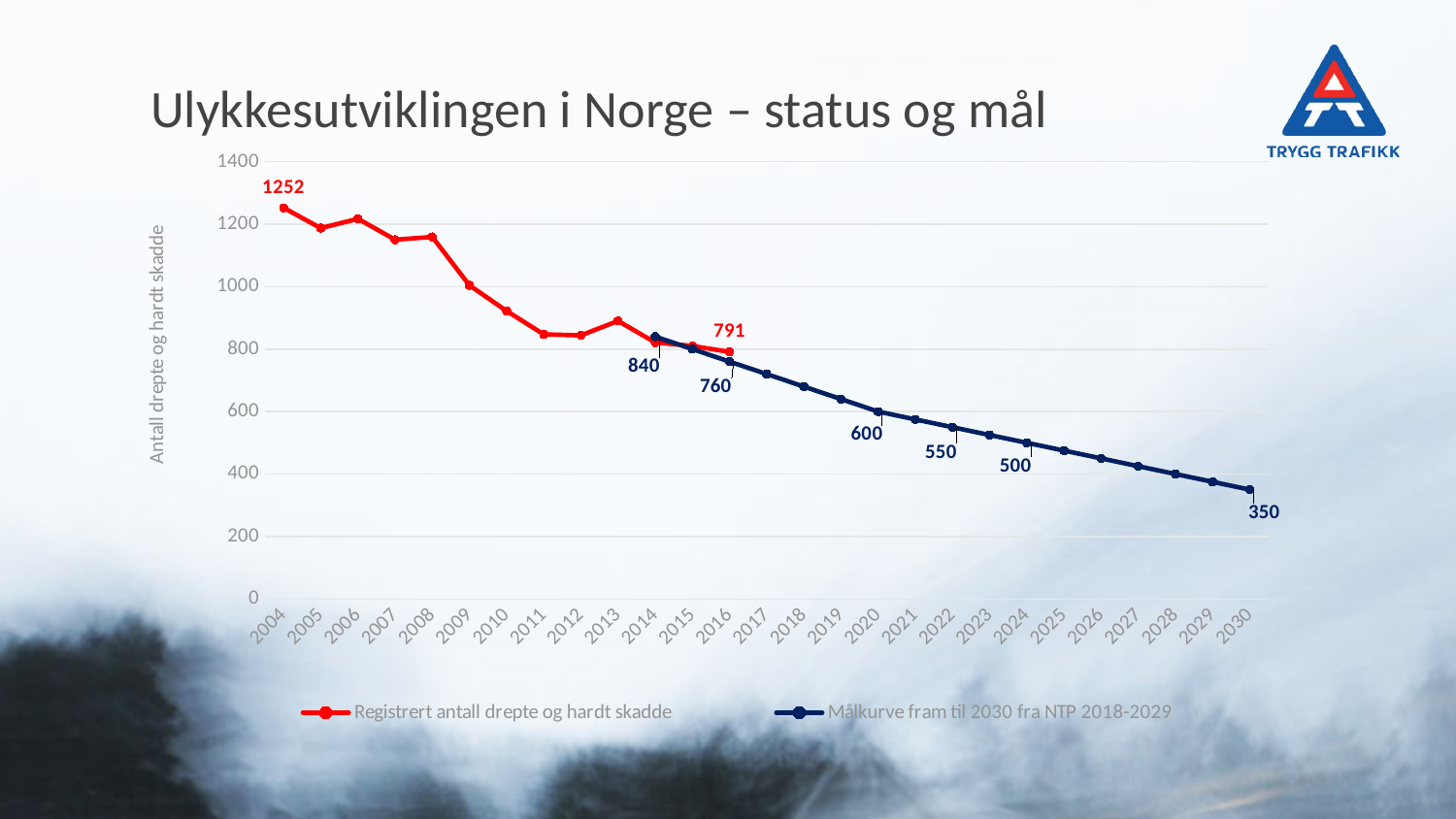
Does the blue target curve rise or fall from 2014 to 2030? Fall What is the registered number of killed and seriously injured (red series) in 2004? 1252 In 2016, which series has the larger value: the red registered series or the blue target curve? The red registered series Is the value of the red series in 2010 greater or less than 1000? less What is the difference between the red series value in 2004 and in 2016? 461 What is the target value (blue series) for 2030? 350 How many series does the legend list? 2 What is the value of the blue target curve in 2020? 600 By how much does the blue target curve fall from 2014 to 2030? 490 What is the value of the blue target curve in 2024? 500 What kind of chart is shown on the slide? Line chart What is the value of the red series 'Registrert antall drepte og hardt skadde' in 2016? 791